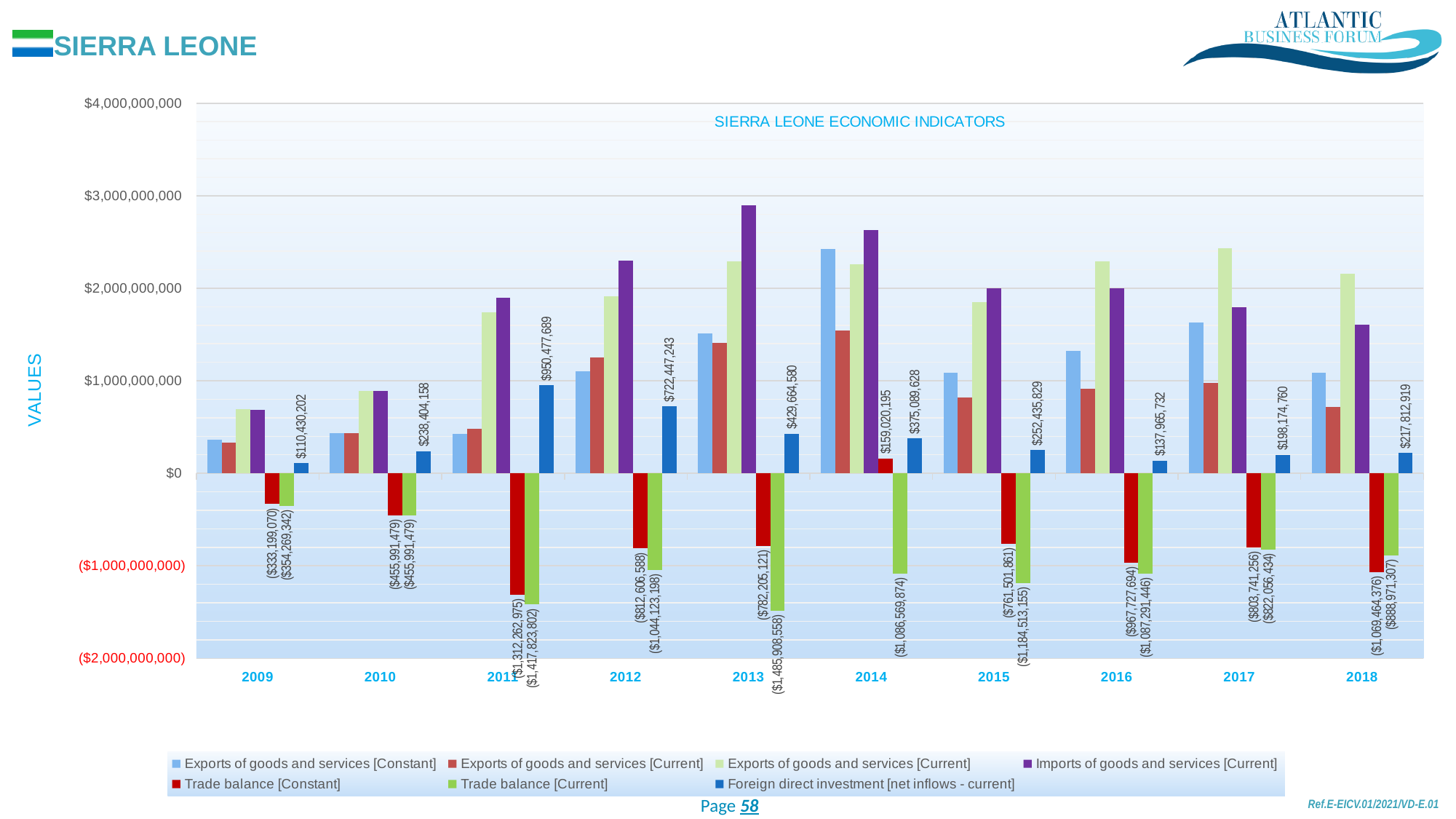
What is the value of Trade balance [Constant] in 2014? $159,020,195 In which year is Foreign direct investment [net inflows - current] lowest? 2009 What is the difference between Foreign direct investment [net inflows - current] in 2011 and in 2012? $228,030,446 How many series does the legend list? 7 What is the value of Trade balance [Current] in 2013? ($1,485,908,558) How many years are shown on the x axis of the chart? 10 What is the value of Foreign direct investment [net inflows - current] in 2011? $950,477,689 What kind of chart is shown on the slide? bar chart Which year has the larger Foreign direct investment [net inflows - current], 2010 or 2018? 2010 In which year is Foreign direct investment [net inflows - current] highest? 2011 What is the title of the chart? SIERRA LEONE ECONOMIC INDICATORS Is the value for Imports of goods and services [Current] in 2013 greater or less than $2,000,000,000? greater